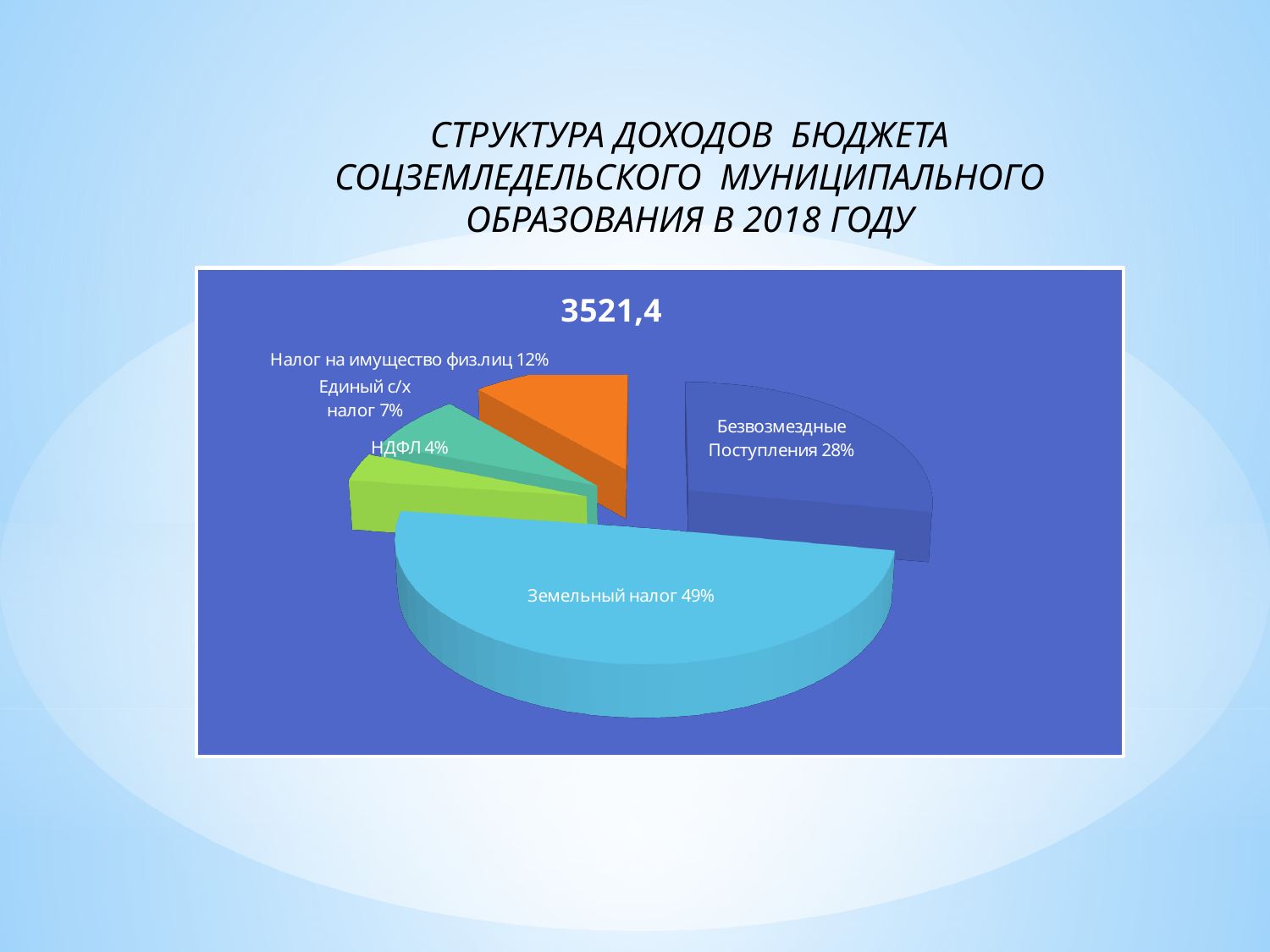
What share of the pie does Земельный налог have? 49% What kind of chart is shown on the slide? pie chart How many slices does the pie chart have? 5 What share of the pie does Налог на имущество физ.лиц have? 12% What share of the pie does Единый с/х налог have? 7% Which slice of the pie is the largest? Земельный налог Which slice of the pie is the smallest? НДФЛ What is the difference in percentage points between Земельный налог and Безвозмездные Поступления? 21 Which is larger, the share for Налог на имущество физ.лиц or the share for Единый с/х налог? Налог на имущество физ.лиц What is the title shown inside the chart area? 3521,4